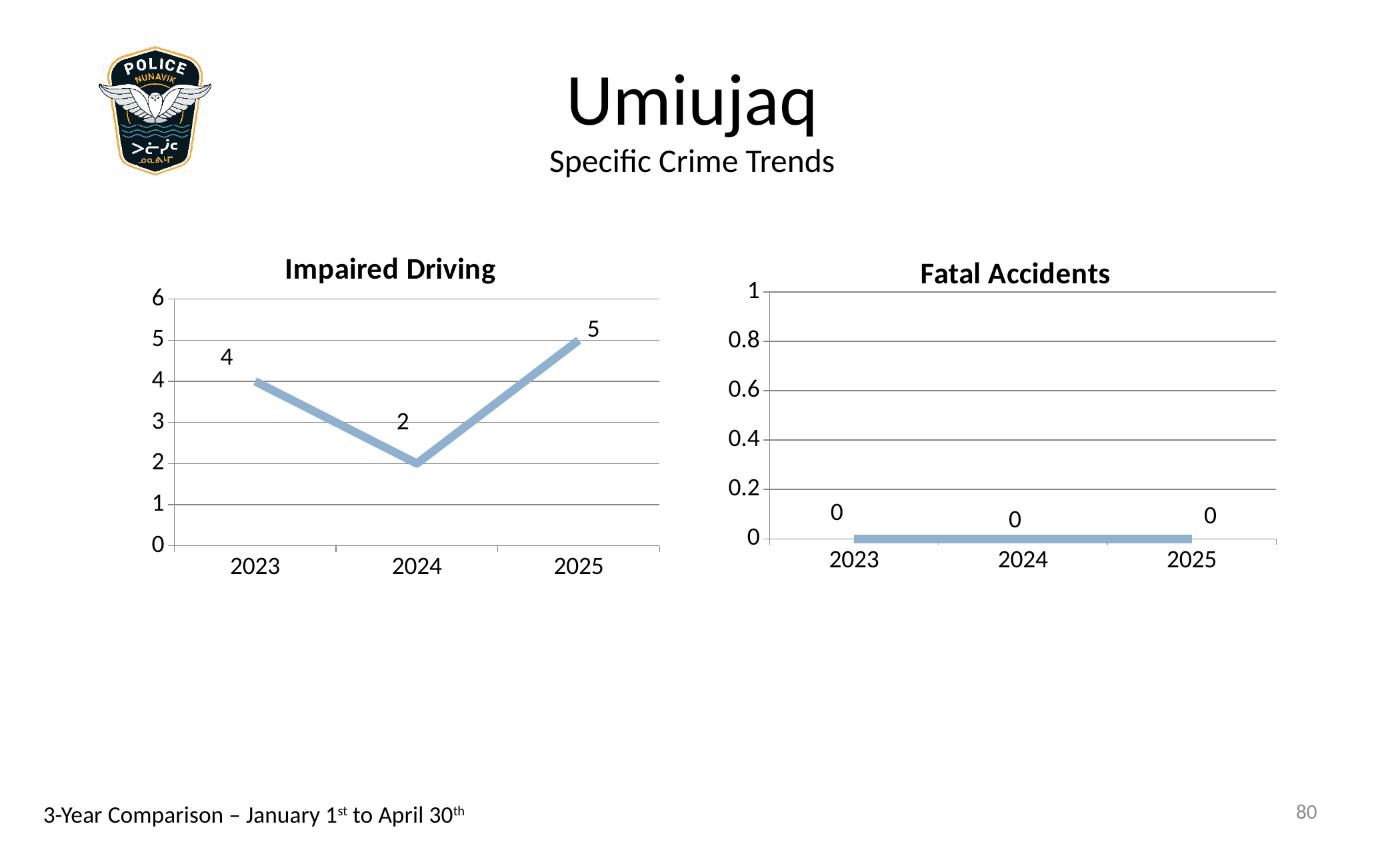
In the Fatal Accidents chart, do the values rise, fall, or stay flat from 2023 to 2025? Stay flat In the Impaired Driving chart, which is larger, the value for 2023 or the value for 2025? 2025 What is the title of the chart on the right side of the slide? Fatal Accidents In the Impaired Driving chart, which year has the highest value? 2025 In the Impaired Driving chart, how many years are plotted? 3 In the Impaired Driving chart, what is the difference between the 2025 and 2024 values? 3 In the Impaired Driving chart, what is the value for 2024? 2 In the Impaired Driving chart, which year has the lowest value? 2024 What kind of chart is the Impaired Driving chart? Line chart In the Impaired Driving chart, what is the value for 2023? 4 In the Fatal Accidents chart, what is the value for 2024? 0 In the Impaired Driving chart, what is the value for 2025? 5